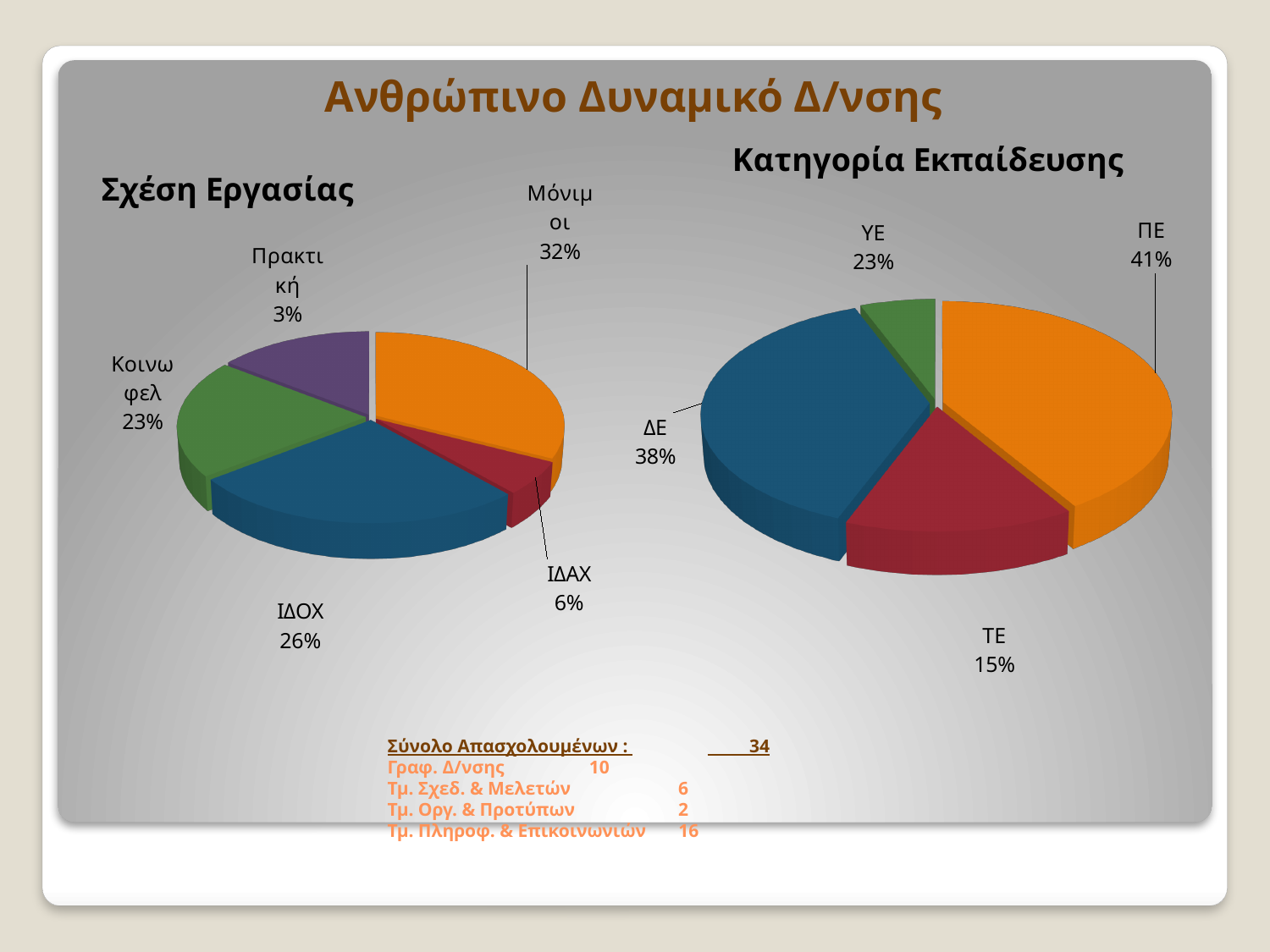
In the "Κατηγορία Εκπαίδευσης" chart, what share is shown for ΤΕ? 15% In the "Σχέση Εργασίας" chart, how many slices does the pie have? 5 In the "Κατηγορία Εκπαίδευσης" chart, how many categories are shown? 4 In the "Σχέση Εργασίας" chart, what share is shown for Μόνιμοι? 32% In the "Κατηγορία Εκπαίδευσης" chart, what share is shown for ΔΕ? 38% In the "Κατηγορία Εκπαίδευσης" chart, which category has the largest share? ΠΕ What type of chart is the "Κατηγορία Εκπαίδευσης" chart? Pie chart In the "Σχέση Εργασίας" chart, which category has the largest share? Μόνιμοι In the "Σχέση Εργασίας" chart, what share is shown for ΙΔΟΧ? 26% In the "Σχέση Εργασίας" chart, what is the difference in percentage points between ΙΔΟΧ and ΙΔΑΧ? 20